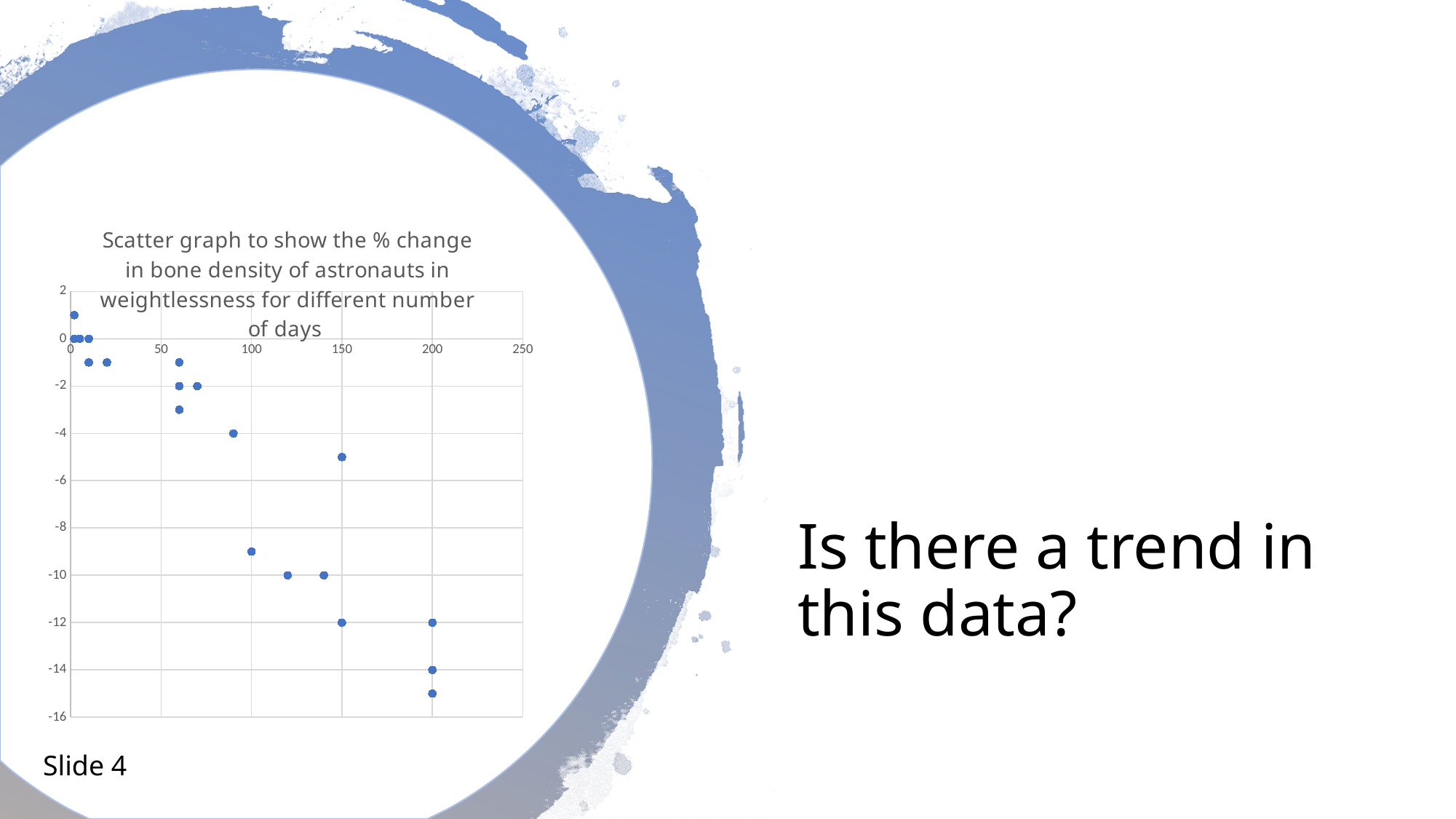
Is the value for the point at 100 days greater or less than -8? less What is the minimum value shown on the y axis? -16 Which has the lower % change: the point at 100 days or the point at 90 days? 100 days At how many days does the lowest % change in bone density occur? 200 Is the highest point at 150 days greater or less than -6? greater What kind of chart is shown on the slide? Scatter chart What is the highest % change value plotted at 200 days? -12 What is the maximum value shown on the x axis? 250 As the number of days increases, do the % change in bone density values rise or fall? Fall Is the highest point at 200 days greater or less than -10? less